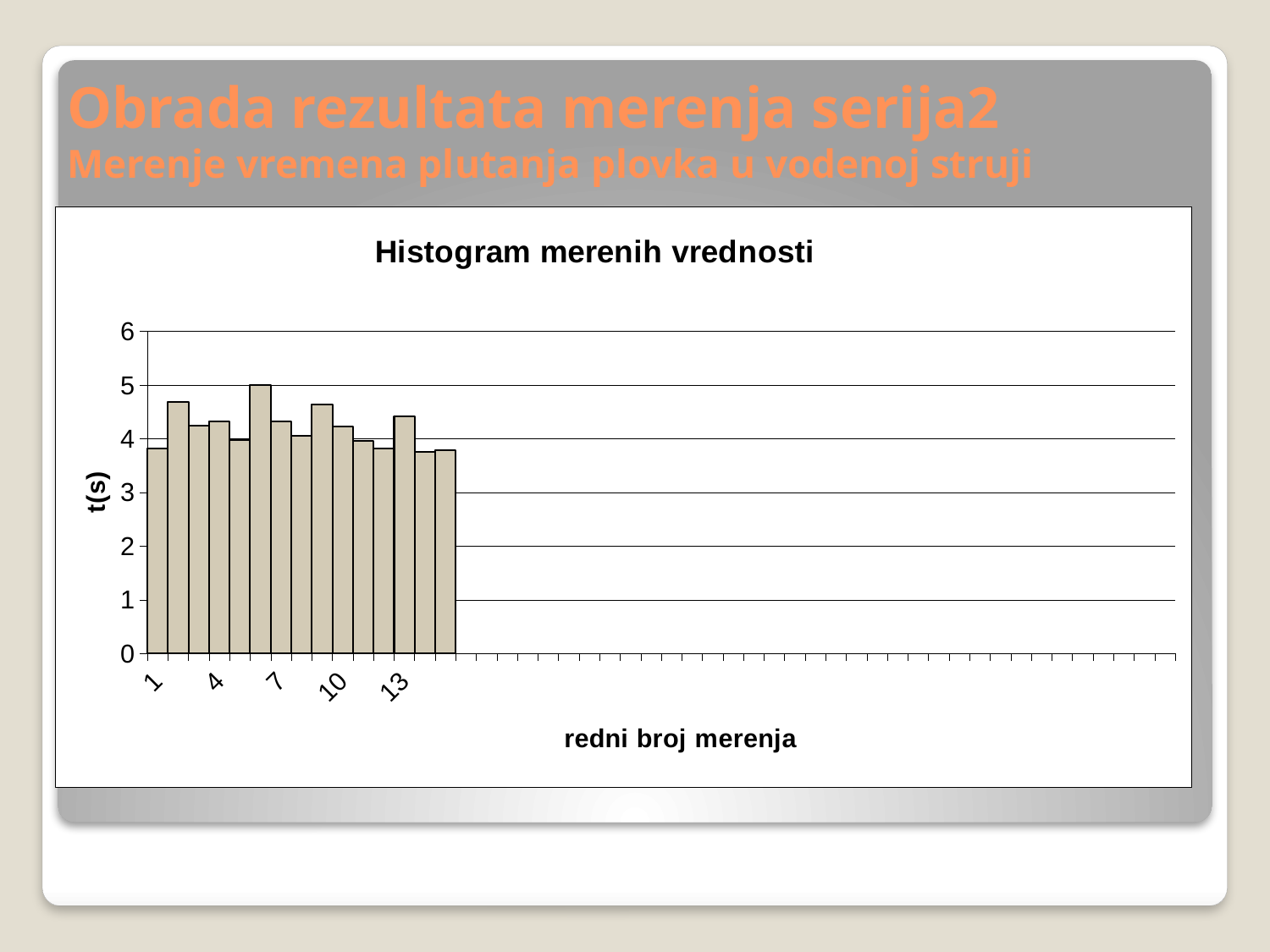
Which measurement number has the highest value? 6 What kind of chart is shown on the slide? bar chart Is the value for measurement 1 greater or less than 4? less Is the value for measurement 13 greater or less than 4? greater Which is larger, the value for measurement 6 or measurement 13? measurement 6 Which is larger, the value for measurement 2 or measurement 1? measurement 2 What is the title of the chart? Histogram merenih vrednosti What is the label of the y axis? t(s) Is the value for measurement 6 greater or less than 4? greater How many bars (measurements) are plotted in the chart? 15